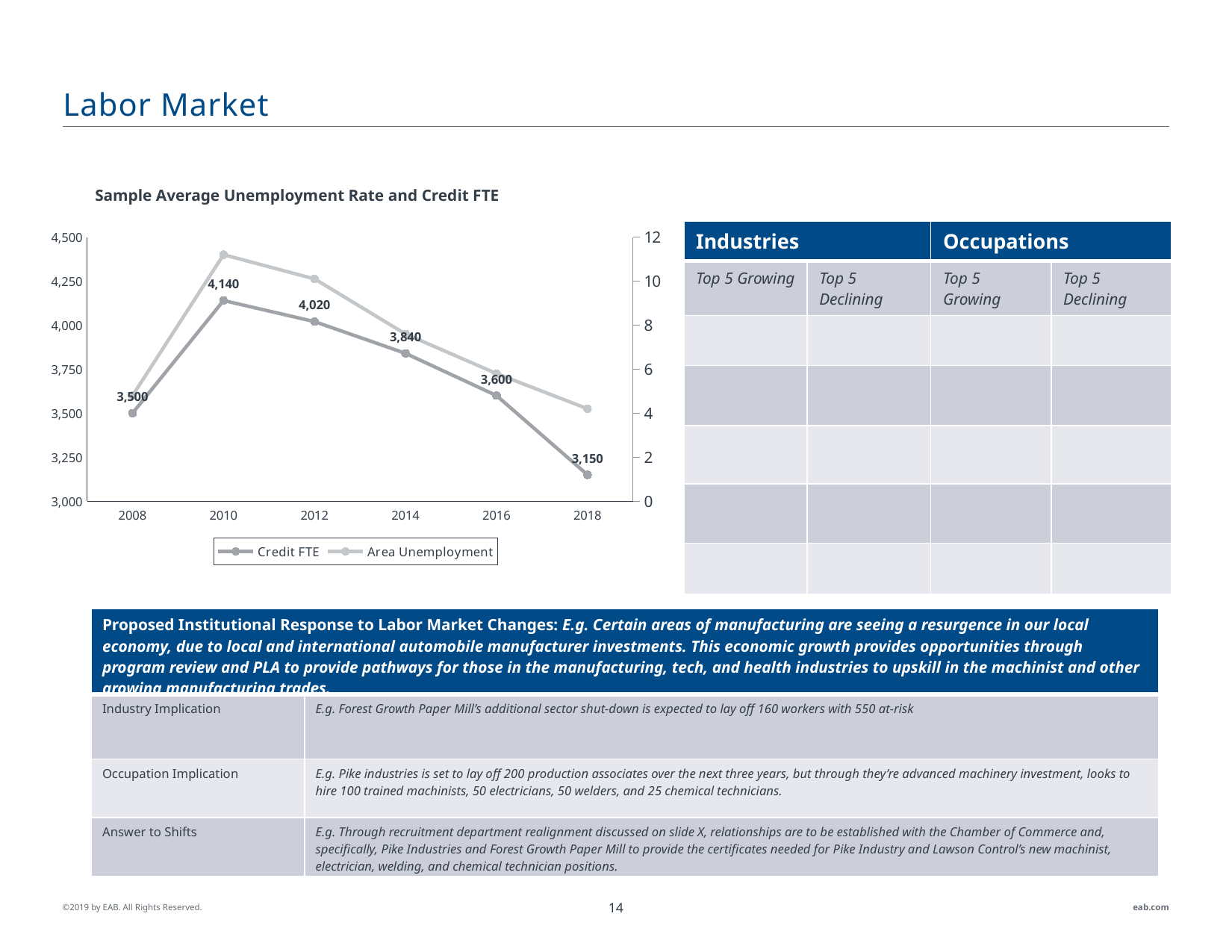
How many years are plotted on the x axis? 6 What is the Credit FTE value for 2010? 4,140 What is the difference between the Credit FTE values for 2010 and 2018? 990 Is the Area Unemployment value for 2010 greater or less than 10? greater Which is larger, the Credit FTE value for 2012 or for 2016? 2012 What is the Credit FTE value for 2014? 3,840 What type of chart is shown on the slide? line chart In which year is Credit FTE lowest? 2018 In which year is Credit FTE highest? 2010 What is the Credit FTE value for 2018? 3,150 Is the Area Unemployment value for 2016 greater or less than 8? less How many series does the legend list? 2